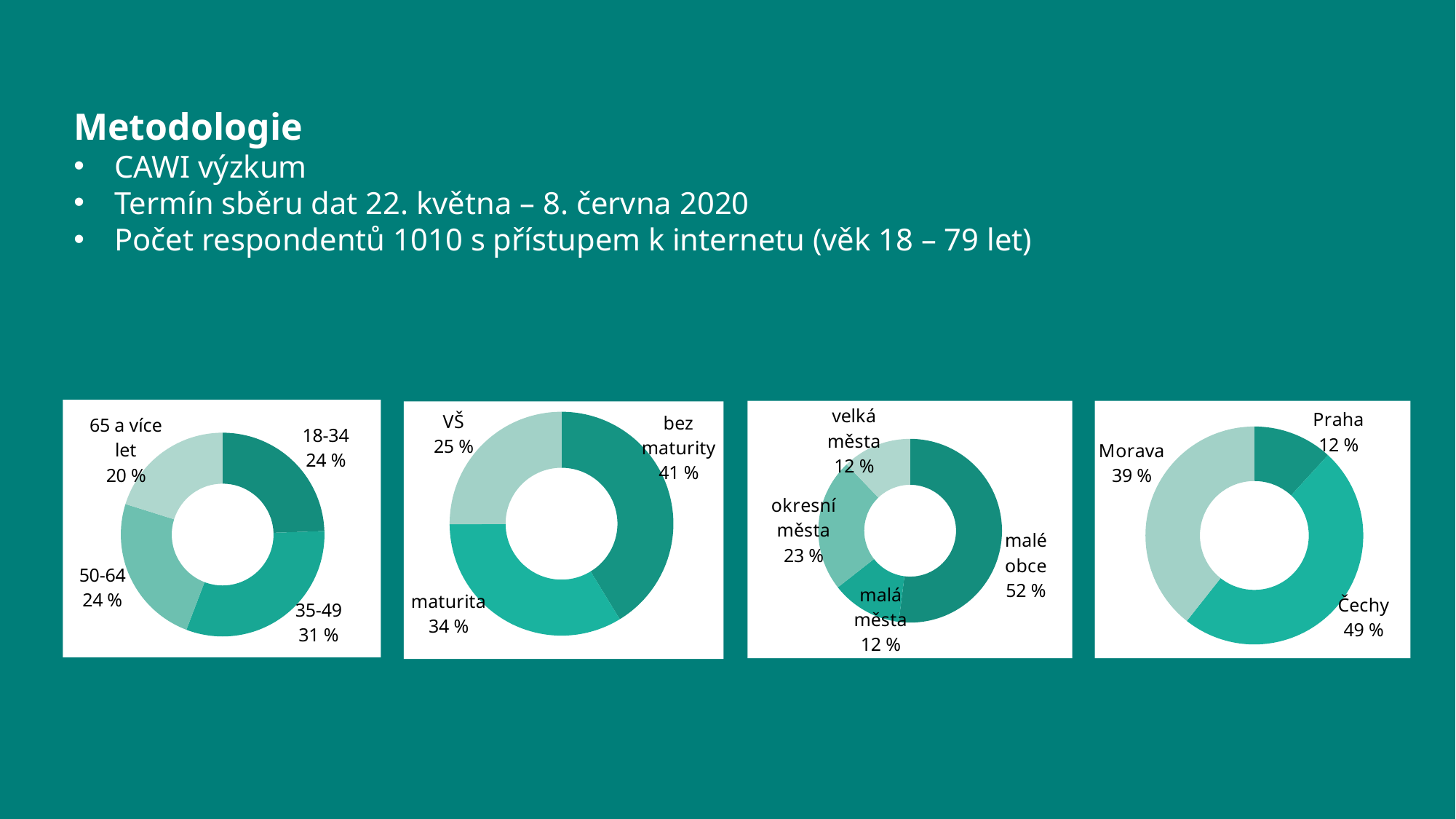
In the leftmost chart, which age group has the smallest share? 65 a více let What type of chart is the rightmost chart? Doughnut chart In the third chart from the left, what share is shown for 'okresní města'? 23 % In the second chart from the left, what is the difference between the shares for 'bez maturity' and 'VŠ'? 16 % In the rightmost chart, what share is shown for Morava? 39 % In the third chart from the left, which category has the largest share? malé obce In the leftmost chart, what share is shown for the 35-49 age group? 31 % In the second chart from the left, which category has the largest share? bez maturity In the second chart from the left, what share is shown for 'bez maturity'? 41 % In the third chart from the left, how many categories are shown? 4 In the rightmost chart, which is larger, the share for Čechy or the share for Morava? Čechy In the leftmost chart, how many age categories are shown? 4